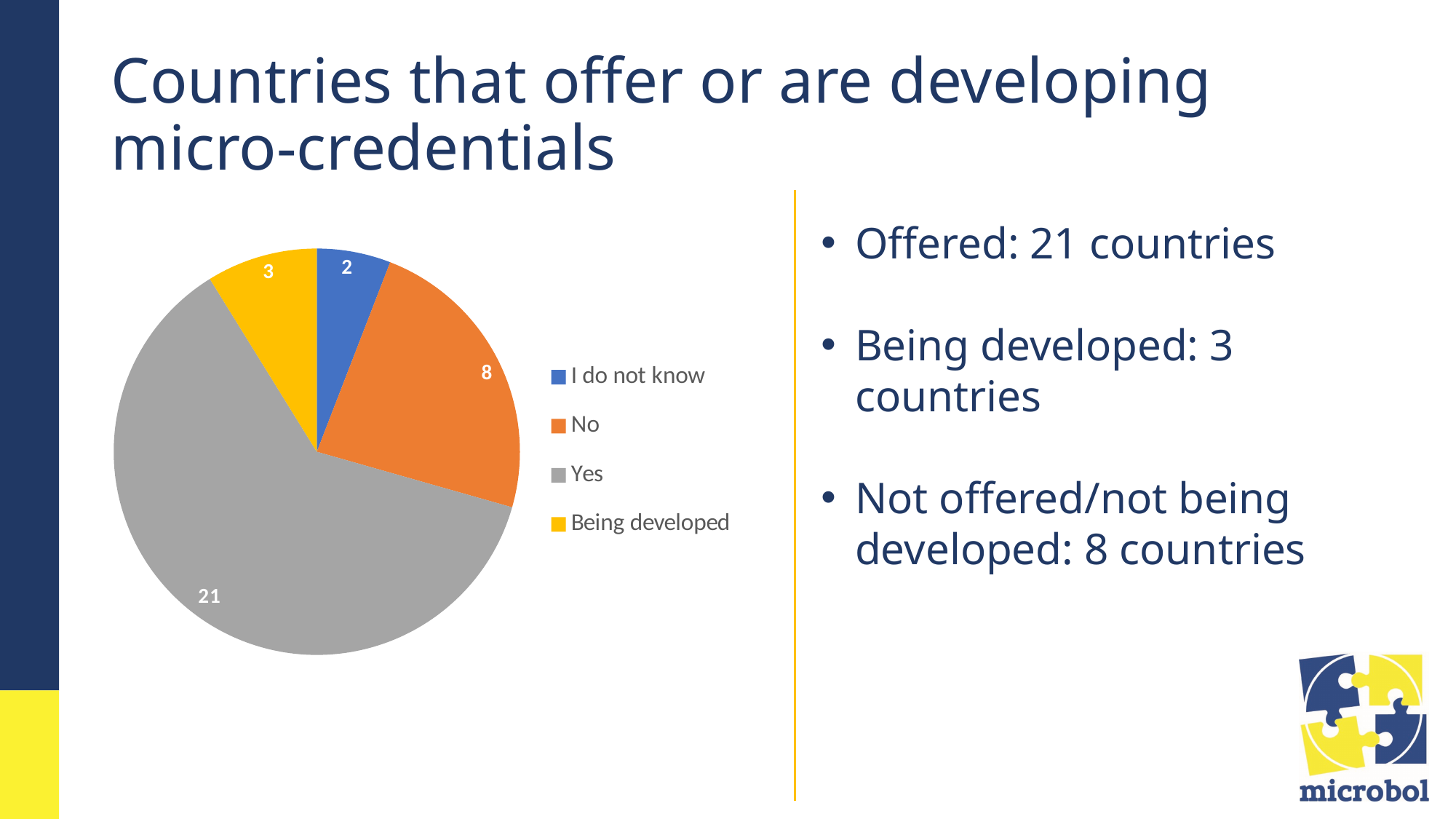
What is the total of all slices in the pie chart? 34 Which category has the smallest slice? I do not know What is the value for the "Yes" slice? 21 What kind of chart is shown on the slide? pie chart Which category has the largest slice? Yes What is the value for the "No" slice? 8 What is the value for the "Being developed" slice? 3 Which is larger, the "No" slice or the "Being developed" slice? No What is the difference between the "Yes" and "No" values? 13 What colour is the "Being developed" slice? yellow How many categories does the pie chart have? 4 What is the value for the "I do not know" slice? 2